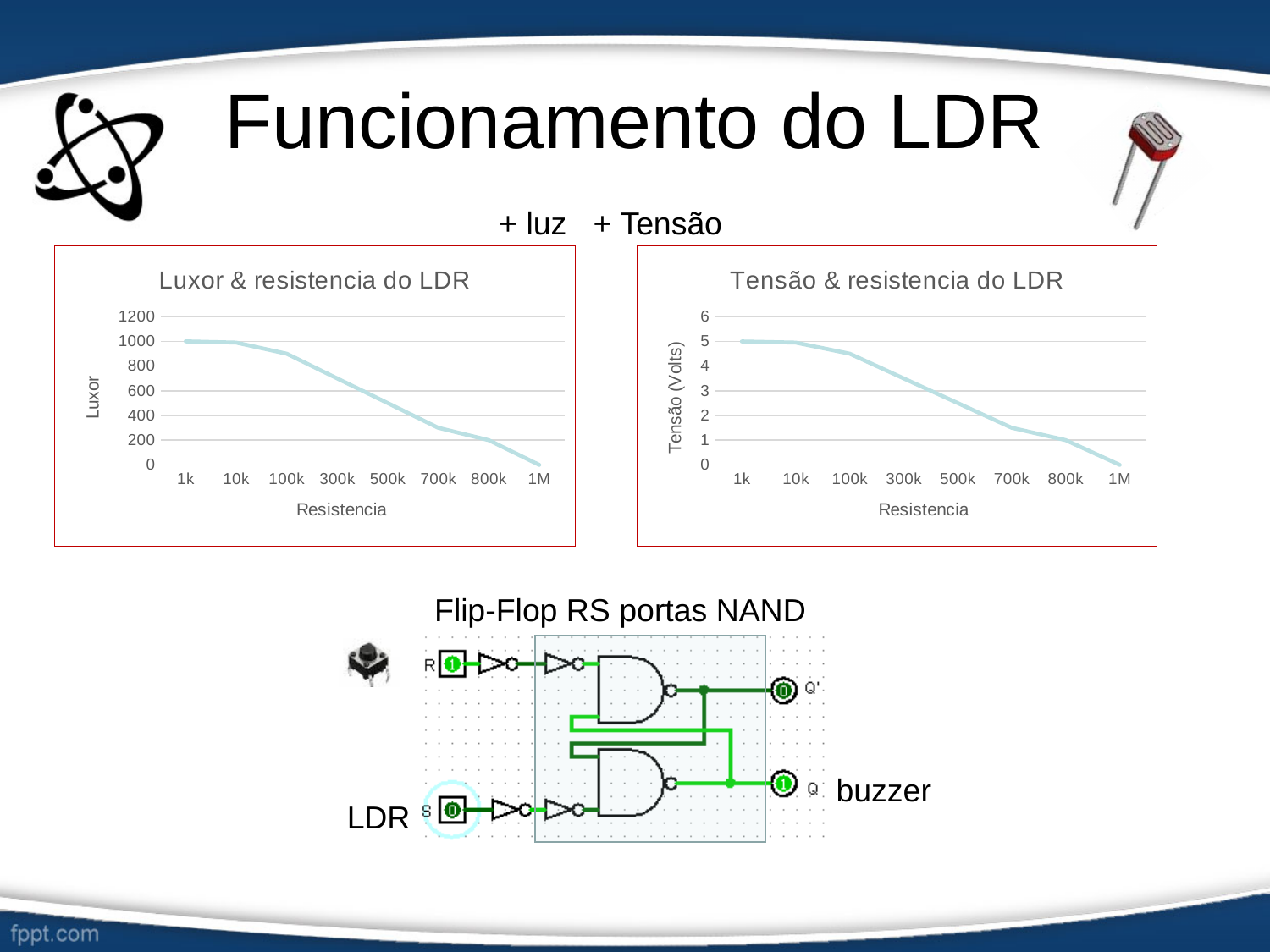
In the 'Tensão & resistencia do LDR' chart, what is the voltage at 1M resistance? 0 In the 'Luxor & resistencia do LDR' chart, which resistance category has the lowest Luxor value? 1M What is the y-axis label of the 'Tensão & resistencia do LDR' chart? Tensão (Volts) In the 'Luxor & resistencia do LDR' chart, what is the Luxor value at 1M resistance? 0 In the 'Luxor & resistencia do LDR' chart, do the values rise or fall as resistance increases along the x axis? fall In the 'Luxor & resistencia do LDR' chart, is the value at 100k greater or less than 800? greater What type of chart is the 'Luxor & resistencia do LDR' chart? line chart In the 'Luxor & resistencia do LDR' chart, is the value at 500k greater or less than 600? less In the 'Tensão & resistencia do LDR' chart, which is larger, the voltage at 100k or at 700k? 100k How many resistance categories are shown on the x axis of the 'Luxor & resistencia do LDR' chart? 8 In the 'Tensão & resistencia do LDR' chart, is the value at 500k greater or less than 3? less